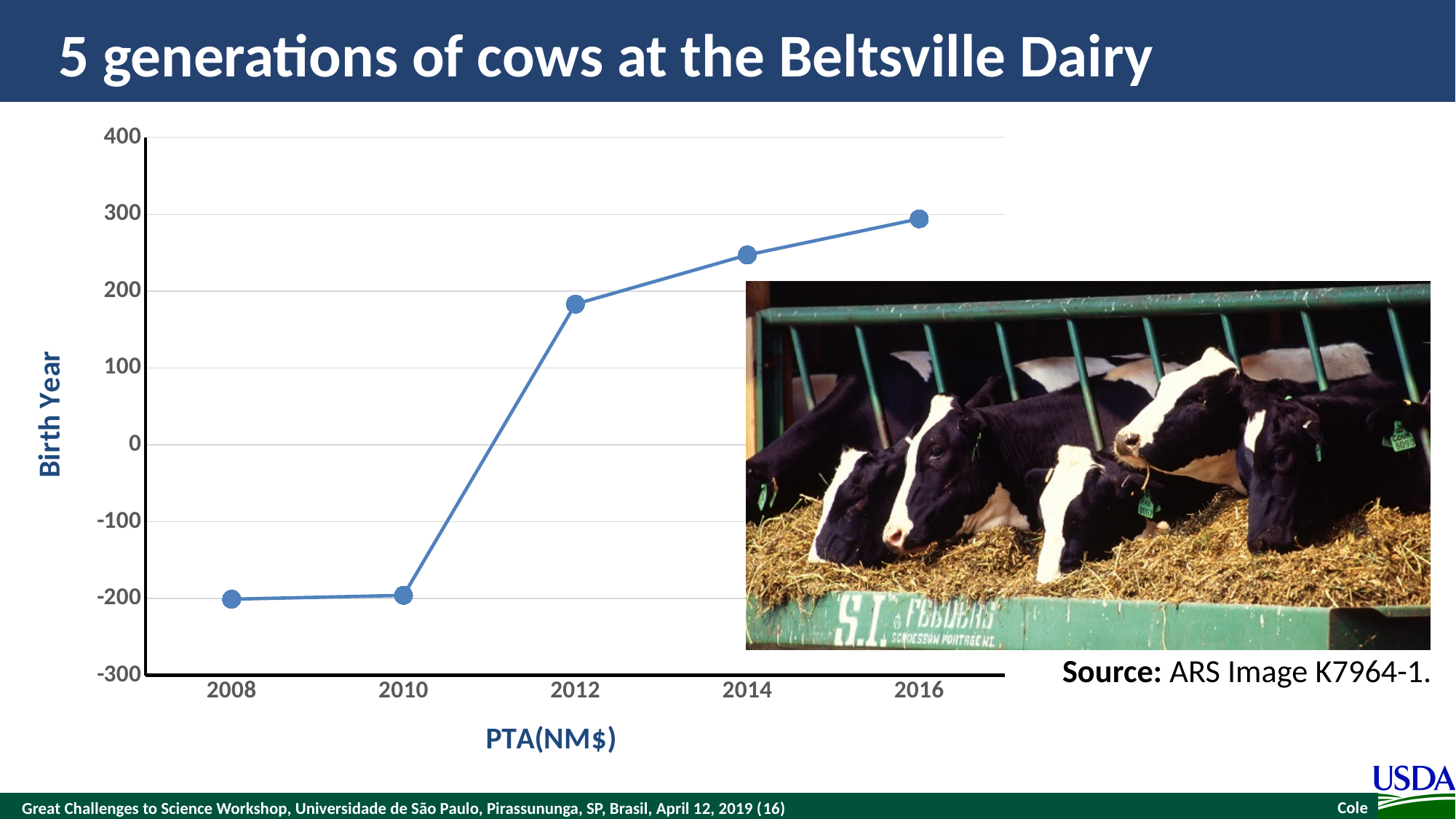
Which year has the highest value on the chart? 2016 Which is larger, the value for 2008 or the value for 2012? 2012 How many data points are plotted on the line chart? 5 Is the value for 2012 greater or less than 100? greater Is the value for 2010 greater or less than -100? less Do the values rise or fall from 2008 to 2016? rise What kind of chart is shown on the slide? line chart What is the label on the vertical axis of the chart? Birth Year What is the label on the horizontal axis of the chart? PTA(NM$) Is the value for 2014 greater or less than 200? greater Which is larger, the value for 2012 or the value for 2014? 2014